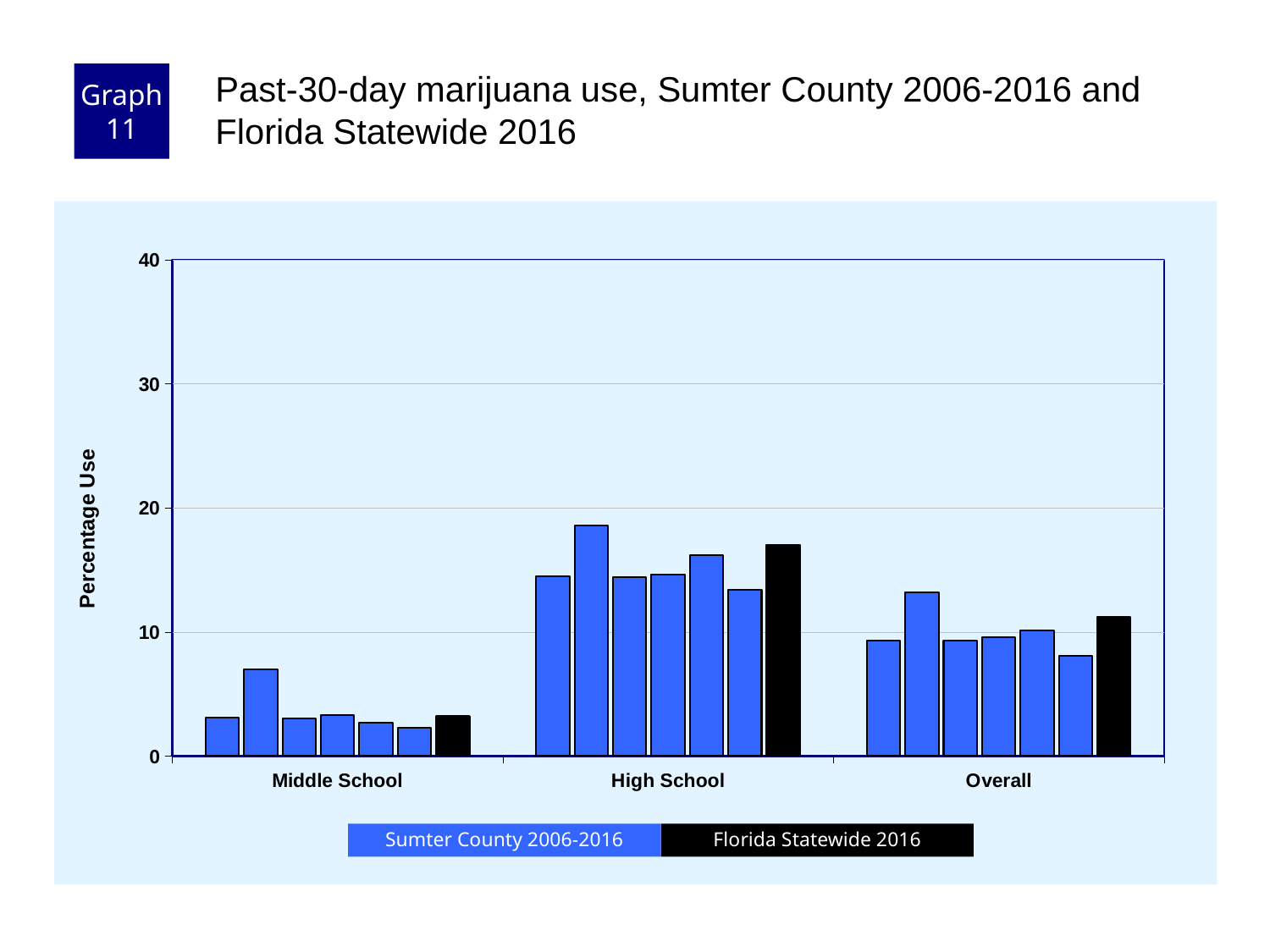
Is the Florida Statewide 2016 value for Overall greater or less than 20? less How many bars are plotted in the High School group? 7 Which is larger, the Florida Statewide 2016 value for High School or for Middle School? High School Which category group has the tallest bars overall? High School Is the tallest Sumter County bar in the High School group greater or less than 10? greater How many categories are shown along the x axis? 3 What is the label on the y axis? Percentage Use What kind of chart is shown on the slide? bar chart Is the Florida Statewide 2016 value for Middle School greater or less than 10? less How many series does the legend list? 2 Which category group has the shortest bars overall? Middle School